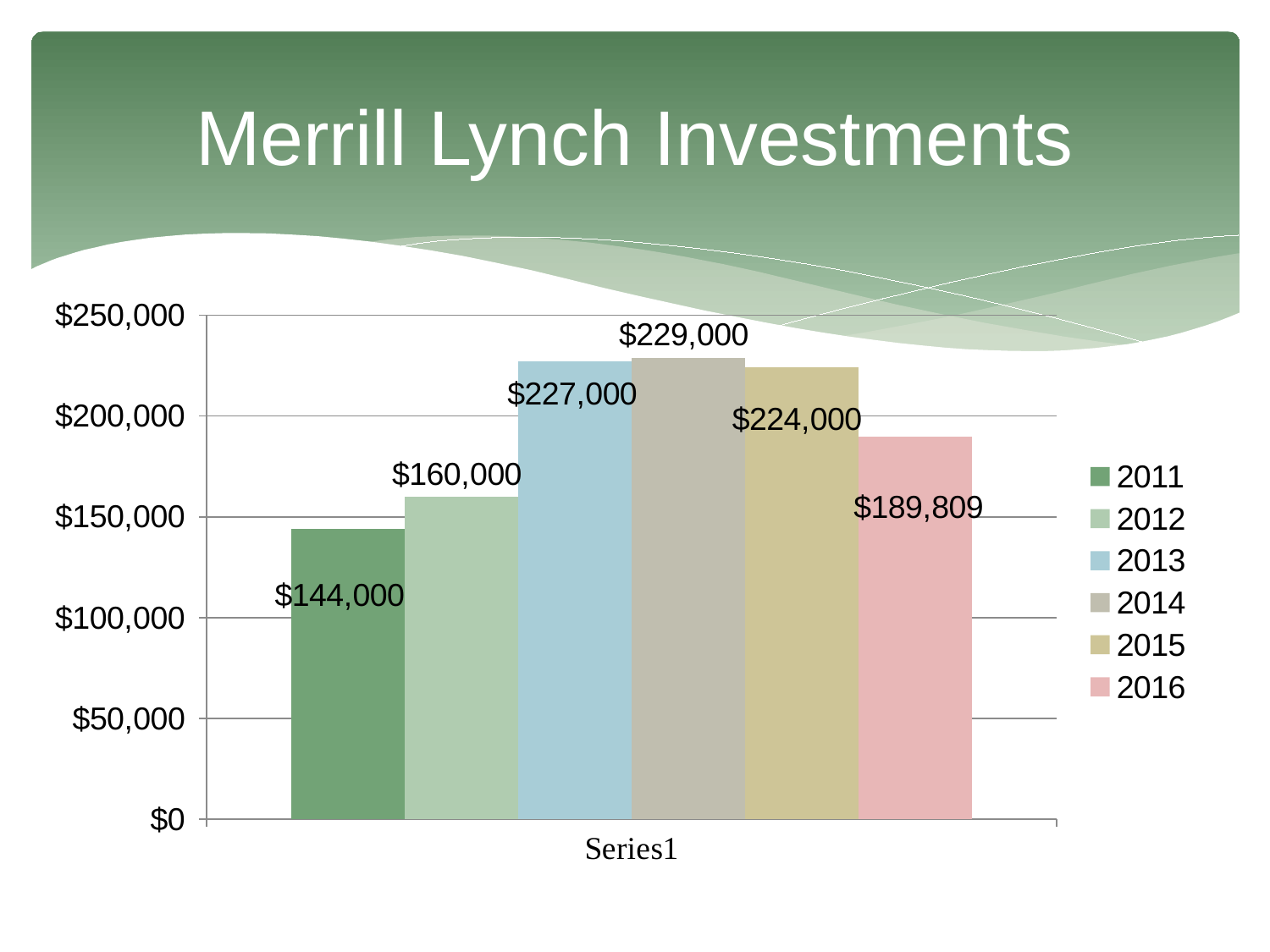
What is the difference between the values for 2012 and 2011? $16,000 What is the value for 2013? $227,000 What is the value for 2016? $189,809 What is the difference between the values for 2014 and 2015? $5,000 How many years are shown in the chart? 6 What kind of chart is shown on the slide? bar chart What is the value for 2011? $144,000 What is the title of the slide? Merrill Lynch Investments Is the value for 2015 greater or less than $200,000? greater Which year has the highest value? 2014 Which year has the lowest value? 2011 Which is larger, the value for 2012 or the value for 2016? 2016